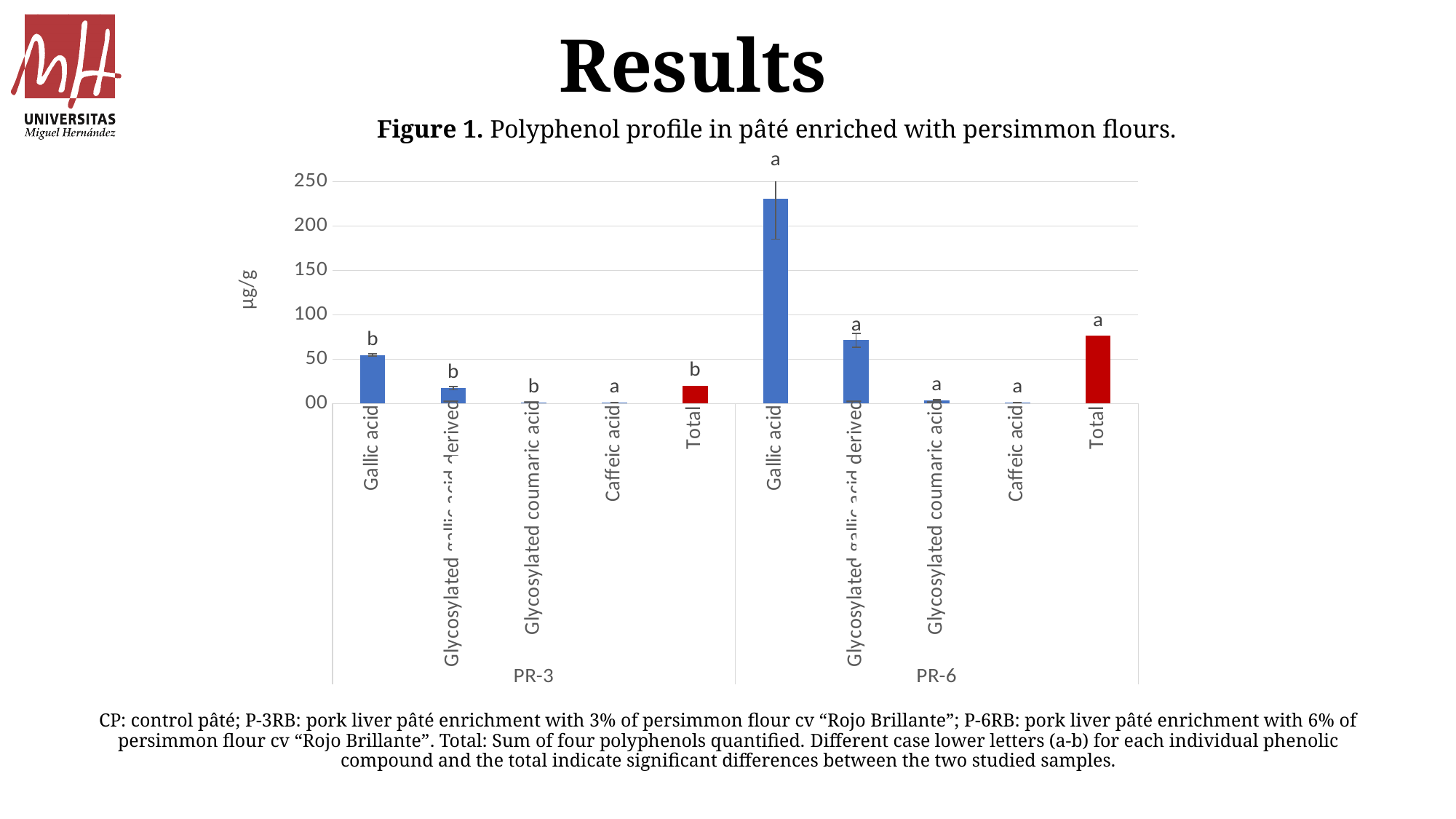
Which has the larger Gallic acid value, PR-3 or PR-6? PR-6 What kind of chart is shown in Figure 1? bar chart Is the value for Gallic acid in PR-3 greater or less than 100? less Is the value for Total in PR-3 greater or less than 50? less How many sample groups are labelled along the x axis of the chart? 2 Which has the larger Total value, PR-3 or PR-6? PR-6 Is the value for Gallic acid in PR-6 greater or less than 200? greater How many bars are plotted in the chart? 10 Which bar is the highest in the chart? Gallic acid in PR-6 What is the label on the y axis of the chart? µg/g